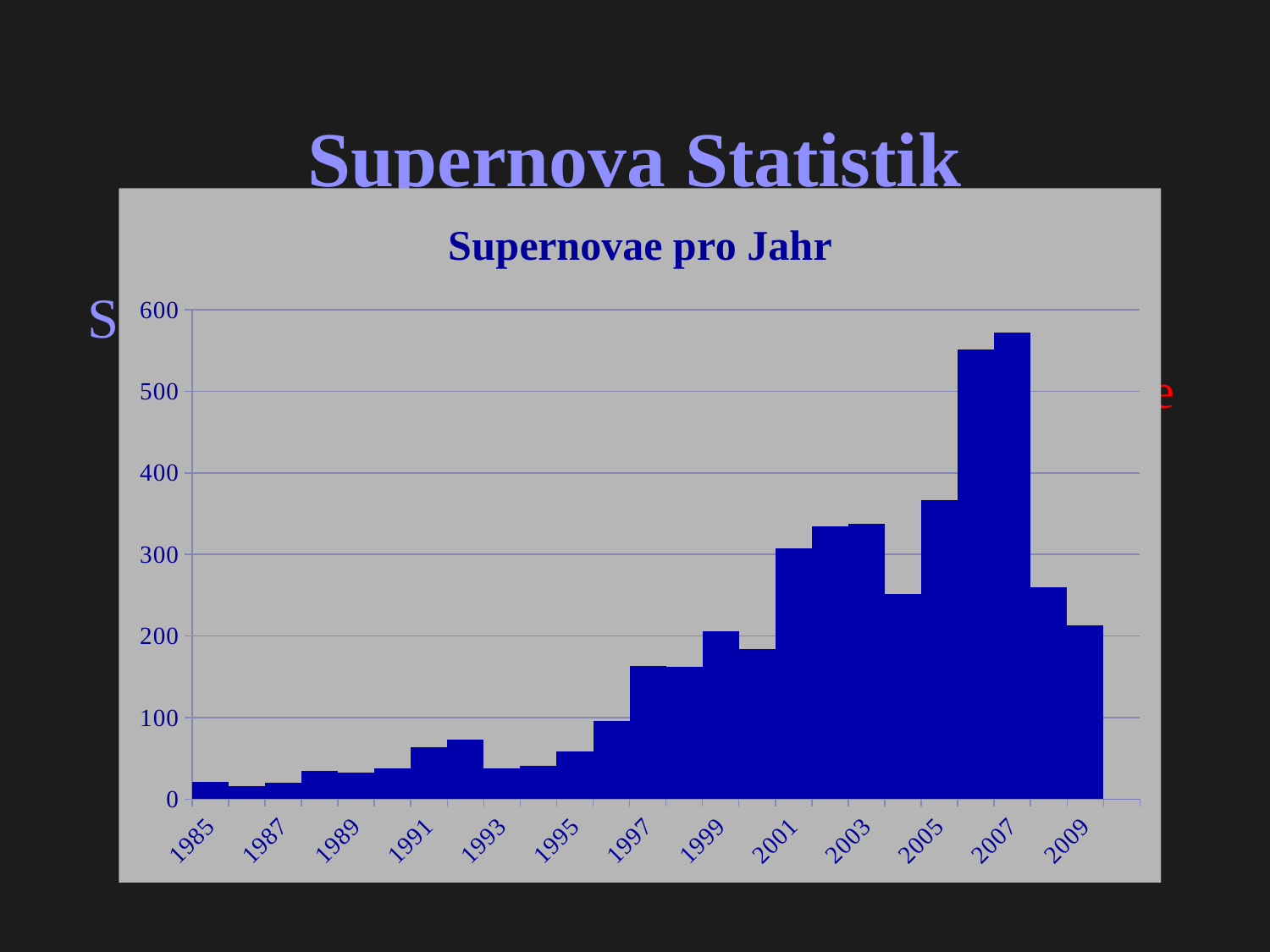
Is the value for 2008 greater or less than 300? less What colour are the bars in the chart? blue What kind of chart is shown on the slide? bar chart Which year has the larger value, 2007 or 2009? 2007 Is the value for 1991 greater or less than 100? less Which year has the larger value, 2003 or 2008? 2003 Is the value for 2007 greater or less than 500? greater Do the values generally rise or fall from 1985 to 2007? rise What is the title of the chart? Supernovae pro Jahr Which year has the highest number of supernovae? 2007